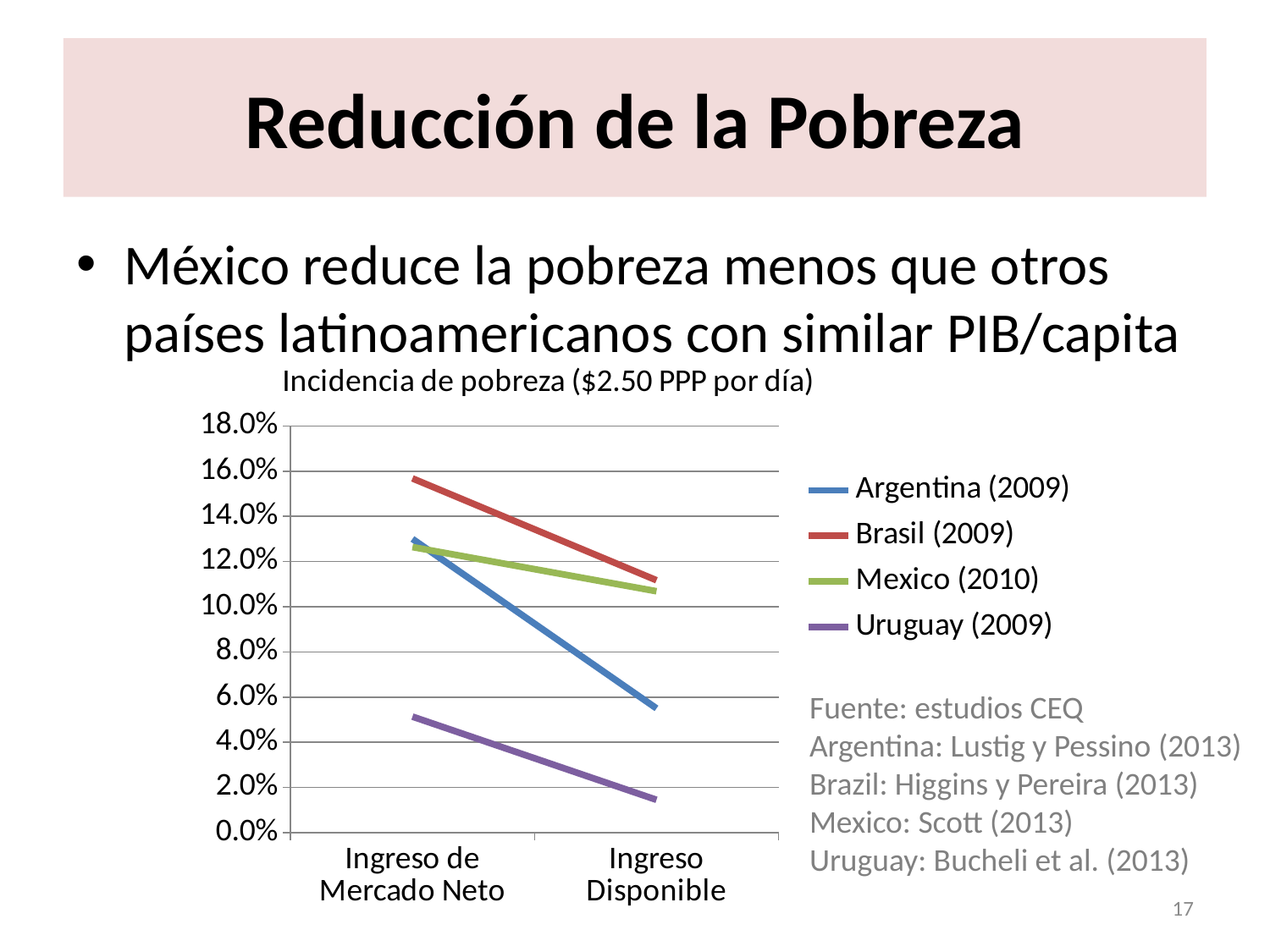
What kind of chart is shown on the slide? line chart Which series has the highest poverty incidence at Ingreso de Mercado Neto? Brasil (2009) What is the title of the chart? Incidencia de pobreza ($2.50 PPP por día) Which series has the lowest poverty incidence at Ingreso Disponible? Uruguay (2009) Is the value for Argentina (2009) at Ingreso Disponible greater or less than 8.0%? less At Ingreso Disponible, which is larger: the value for Argentina (2009) or the value for Uruguay (2009)? Argentina (2009) How many categories are shown on the x axis? 2 Is the value for Uruguay (2009) at Ingreso Disponible greater or less than 2.0%? less At Ingreso Disponible, which is larger: the value for Mexico (2010) or the value for Argentina (2009)? Mexico (2010) How many series does the legend list? 4 Is the value for Brasil (2009) at Ingreso de Mercado Neto greater or less than 14.0%? greater Does the poverty incidence for Argentina (2009) rise or fall from Ingreso de Mercado Neto to Ingreso Disponible? fall